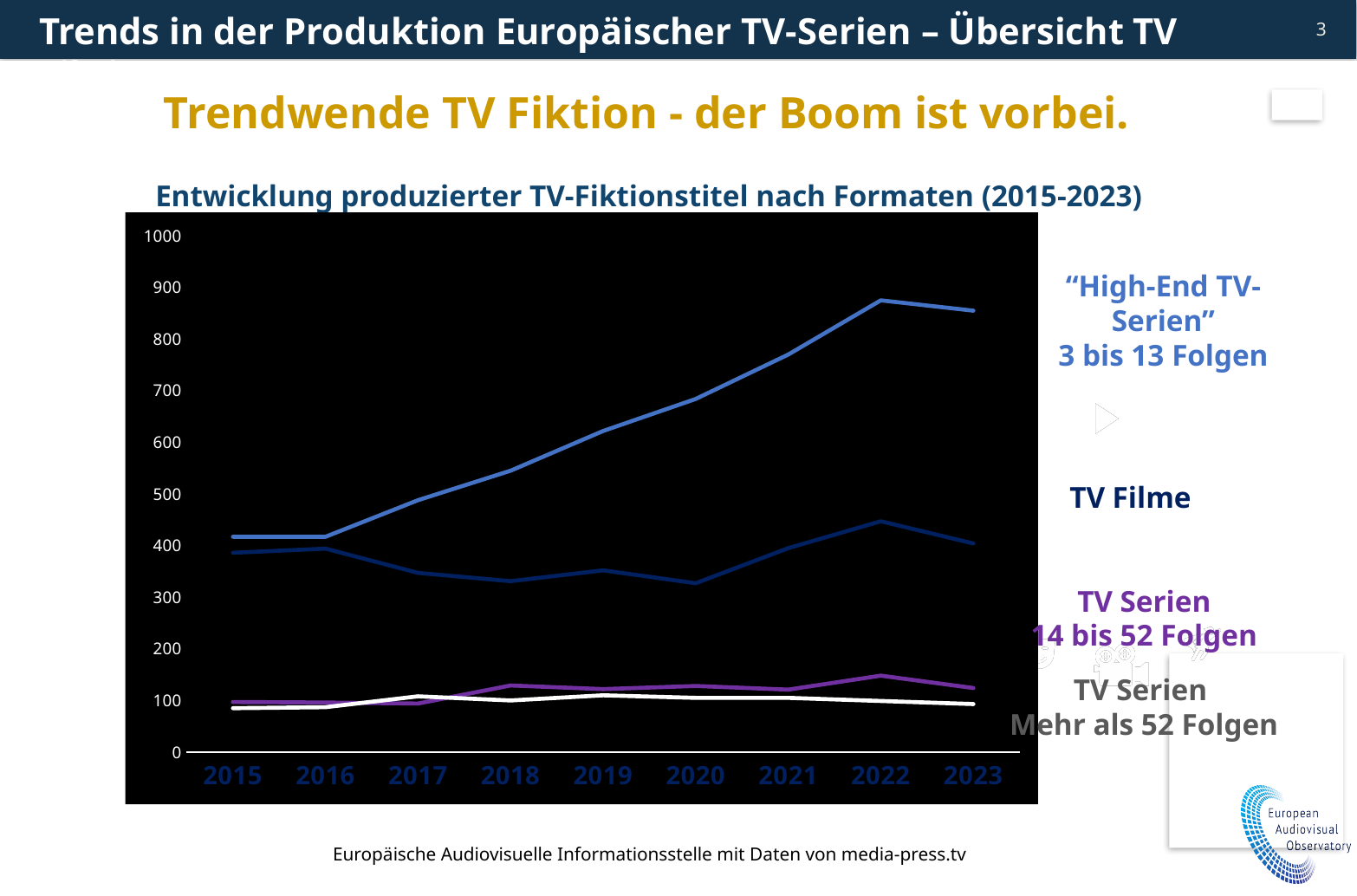
Which is larger in 2023: High-End TV-Serien (3 bis 13 Folgen) or TV Filme? High-End TV-Serien (3 bis 13 Folgen) Which series has the highest value in 2023? High-End TV-Serien (3 bis 13 Folgen) Is the value for TV Filme in 2020 greater or less than 400? less What is the title of the chart? Entwicklung produzierter TV-Fiktionstitel nach Formaten (2015-2023) In which year does the High-End TV-Serien (3 bis 13 Folgen) line reach its highest value? 2022 Is the value for TV Serien 14 bis 52 Folgen in 2022 greater or less than 100? greater What kind of chart is shown on the slide? line chart Which series has the lowest value in 2023? TV Serien Mehr als 52 Folgen How many series are plotted in the chart? 4 How many years are shown on the x axis of the chart? 9 Does the High-End TV-Serien (3 bis 13 Folgen) line rise or fall from 2015 to 2022? rise Is the value for High-End TV-Serien (3 bis 13 Folgen) in 2022 greater or less than 800? greater